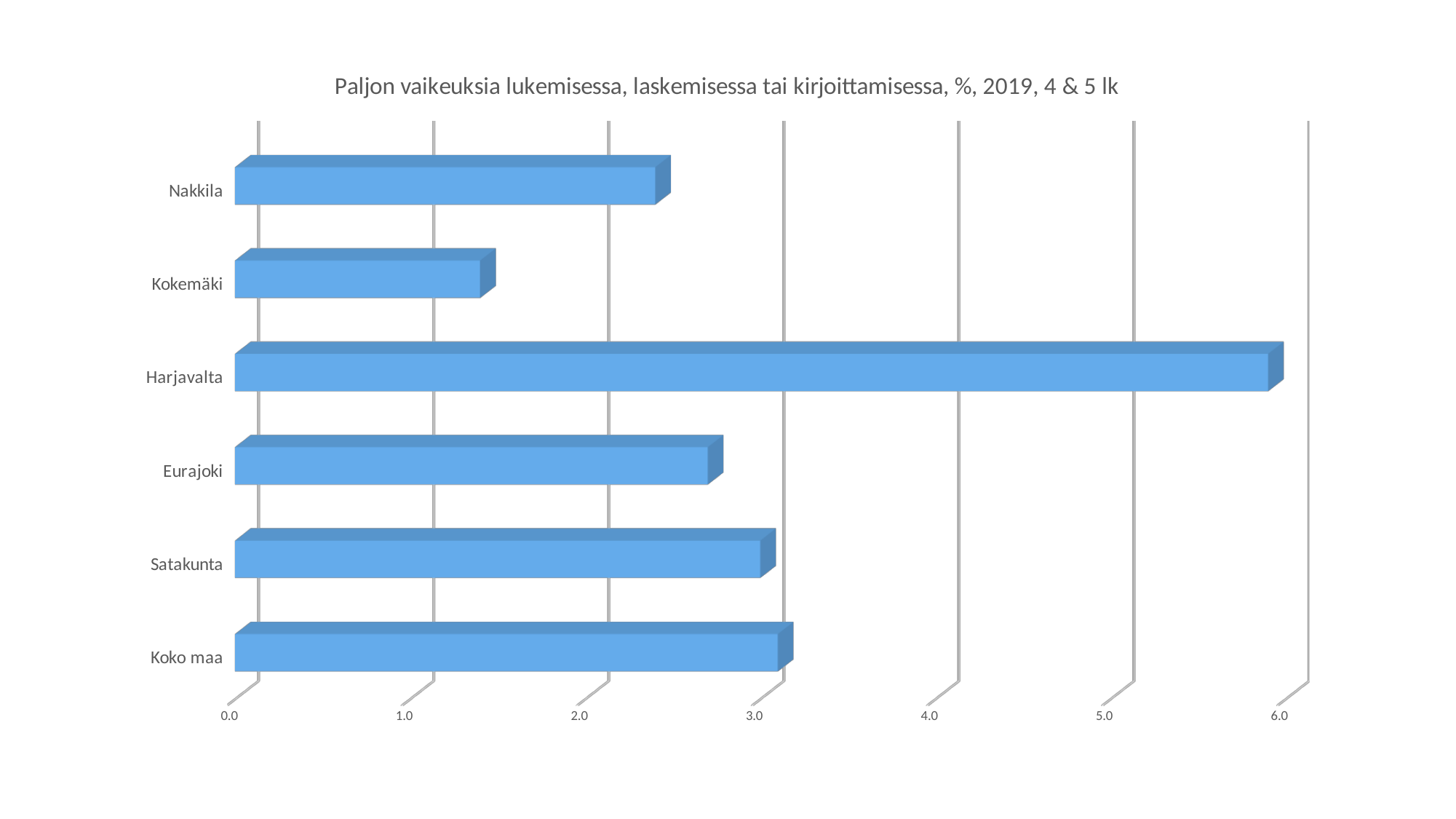
Which category has the lowest value? Kokemäki What is the title of the chart? Paljon vaikeuksia lukemisessa, laskemisessa tai kirjoittamisessa, %, 2019, 4 & 5 lk Which has a larger value, Harjavalta or Kokemäki? Harjavalta How many categories are shown on the chart? 6 Which category has the highest value? Harjavalta Is the value for Eurajoki greater or less than 3.0? less Is the value for Kokemäki greater or less than 1.0? greater Which has a larger value, Nakkila or Eurajoki? Eurajoki Is the value for Kokemäki greater or less than 2.0? less What kind of chart is shown on the slide? bar chart